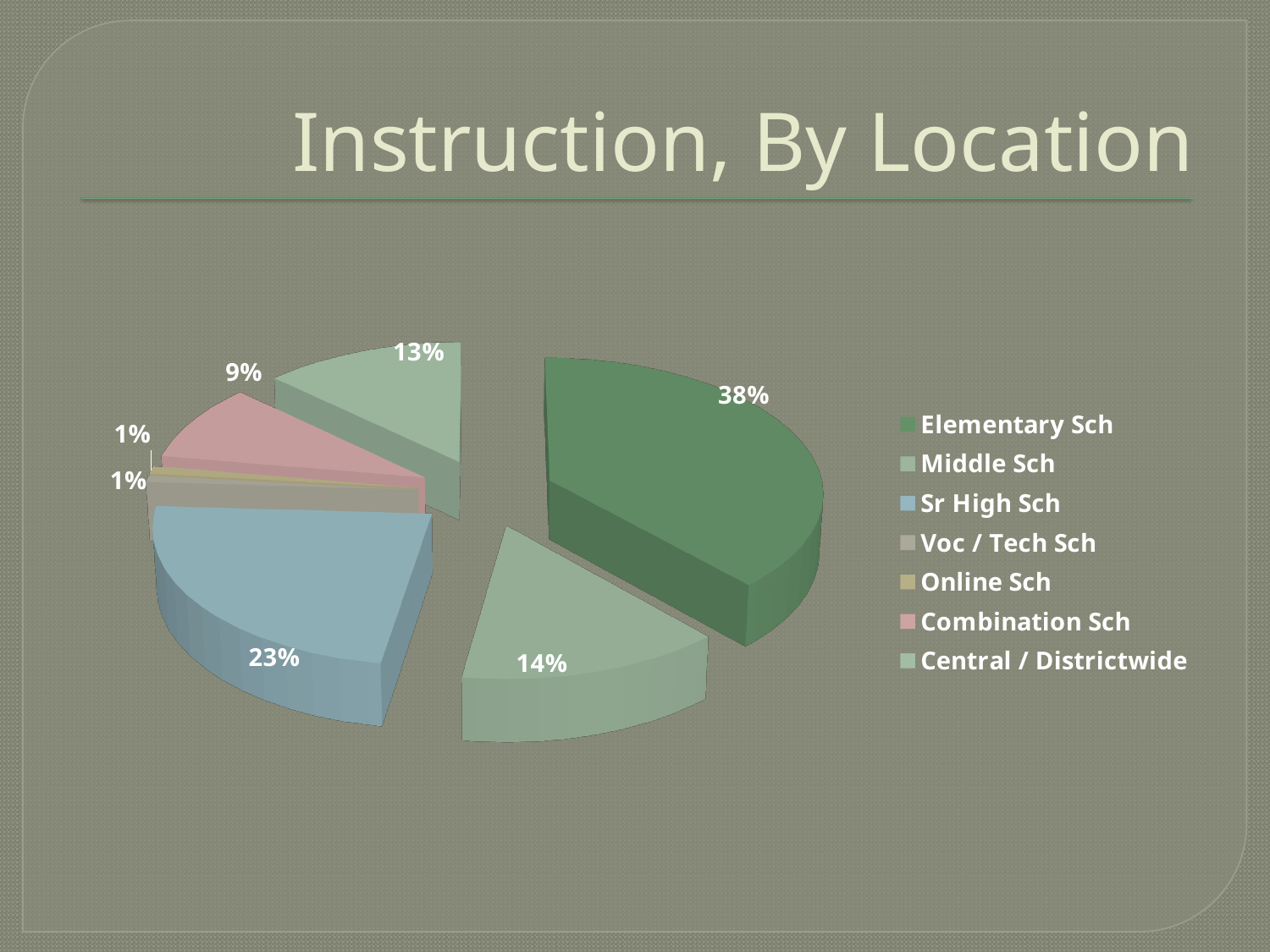
What is the difference between the Elementary Sch share and the Sr High Sch share? 15% What share of the pie does Central / Districtwide represent? 13% What kind of chart is shown on the slide? pie chart What share of the pie does Middle Sch represent? 14% What share of the pie does Combination Sch represent? 9% How many categories does the legend list? 7 Which is larger, the Middle Sch share or the Central / Districtwide share? Middle Sch Which category has the largest slice of the pie? Elementary Sch What is the title of the chart? Instruction, By Location